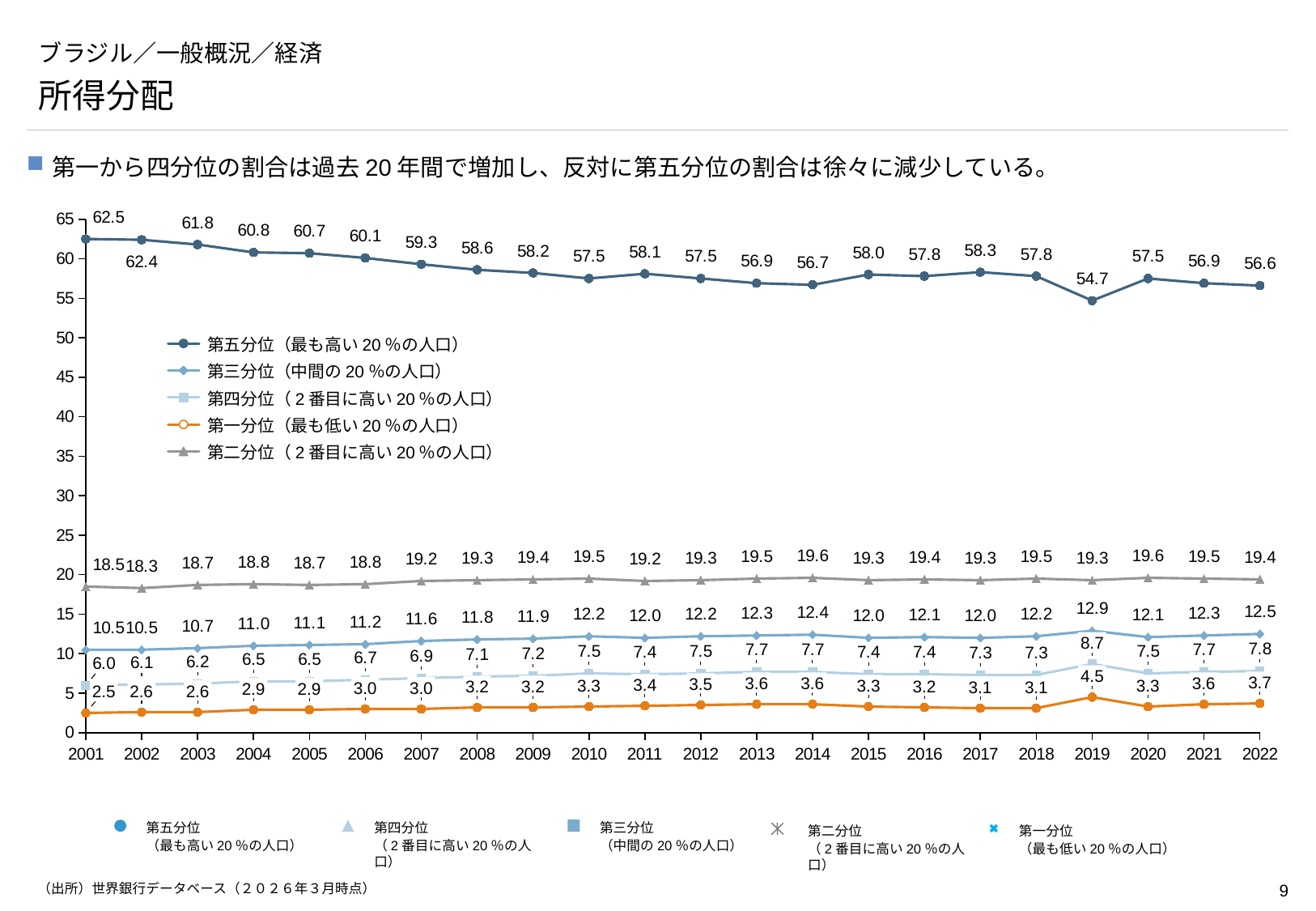
What is the value for 第一分位 in 2022? 3.7 In which year is the 第五分位 series at its highest? 2001 What is the difference between the 第五分位 value in 2001 and in 2022? 5.9 What is the value for 第二分位 in 2014? 19.6 How many years are plotted on the x axis? 22 In which year is the 第五分位 series at its lowest? 2019 What is the value for 第五分位 in 2019? 54.7 Which is larger, the 第三分位 value in 2019 or in 2020? 2019 How many series does the legend list? 5 Is the value for 第四分位 in 2019 greater or less than 5? greater Does the 第五分位 series generally rise or fall from 2001 to 2022? fall What kind of chart is shown on the slide? line chart